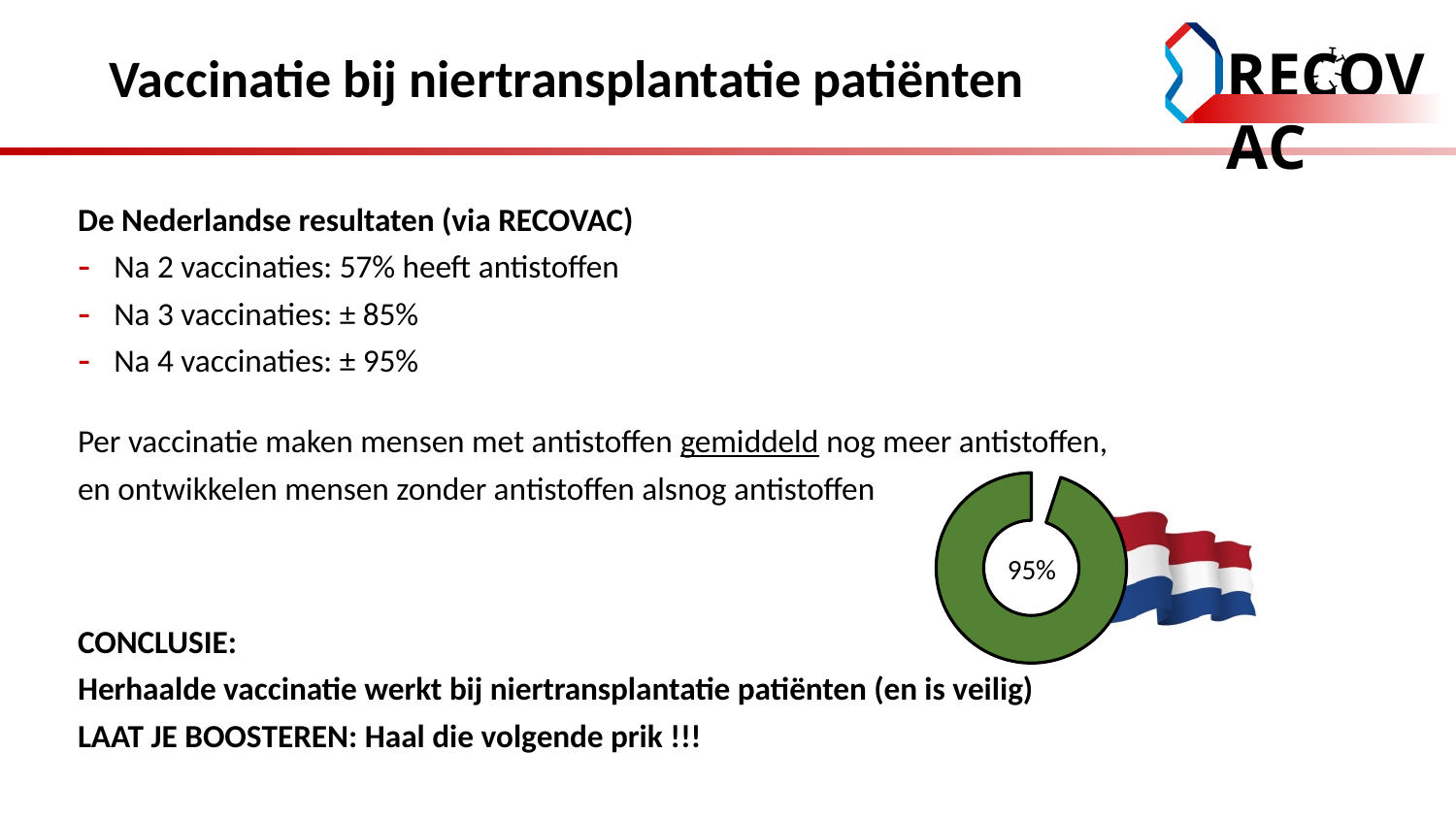
Which segment of the doughnut chart is larger, the green one or the white one? the green one What percentage is printed in the centre of the doughnut chart? 95% Is the green segment of the doughnut chart greater or less than 50% of the whole? greater What share of the doughnut chart is left for the small white segment? 5% What share of the doughnut chart does the green segment represent? 95% What kind of chart is shown on the slide? doughnut chart What colour is the large segment of the doughnut chart? green How many segments does the doughnut chart have? 2